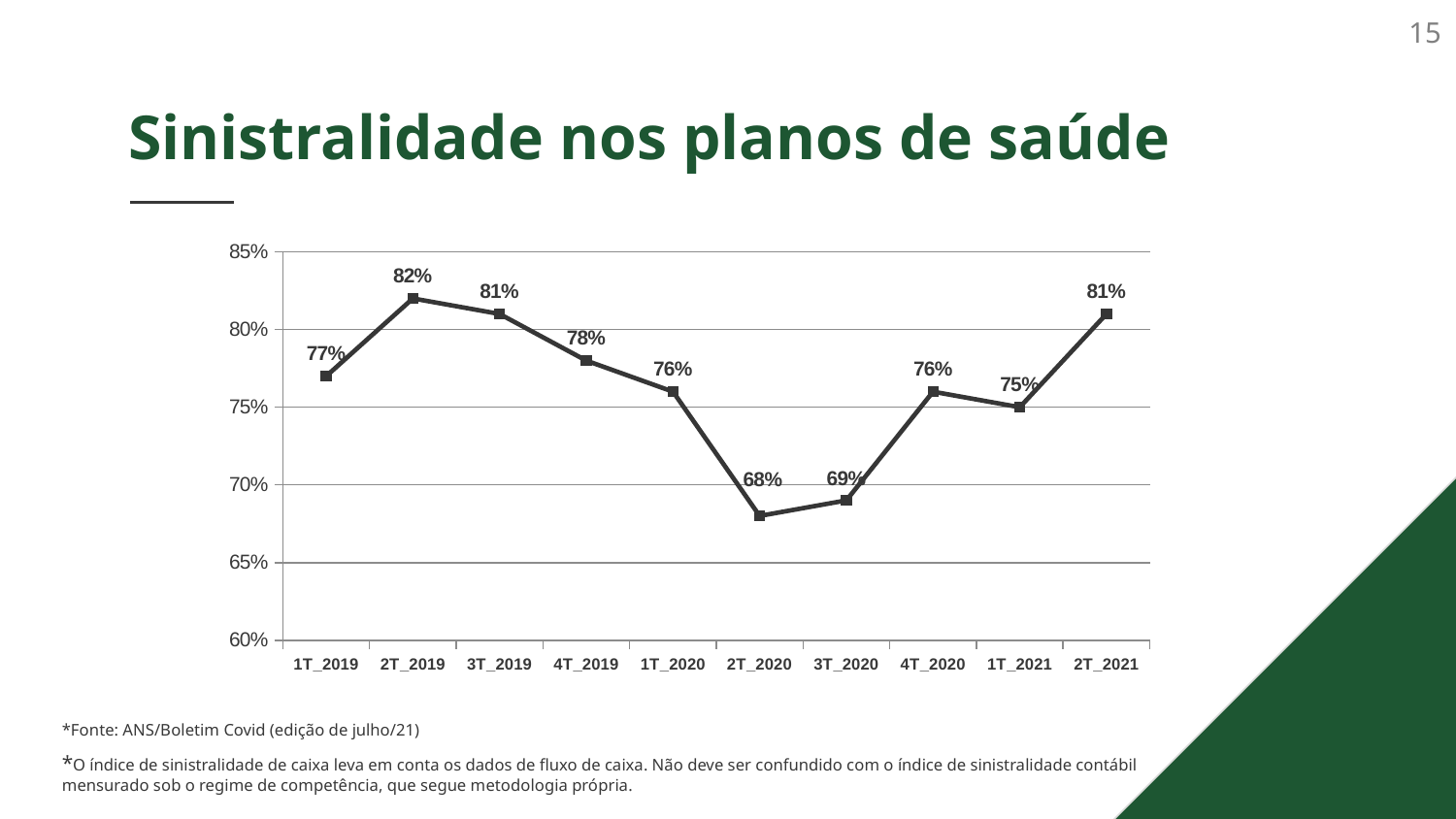
Is the value for 3T_2020 greater or less than 70%? less Which quarter has the lowest value? 2T_2020 Which quarter has the highest value? 2T_2019 What is the title of the slide containing the chart? Sinistralidade nos planos de saúde Which is larger, the value for 1T_2019 or the value for 4T_2019? 4T_2019 What is the difference between the values for 2T_2019 and 2T_2020? 14% How many quarters are plotted on the x axis? 10 What is the value for 1T_2021? 75% Do the values rise or fall from 3T_2020 to 2T_2021? rise What is the value for 2T_2020? 68% What kind of chart is shown on the slide? line chart What is the value for 2T_2019? 82%